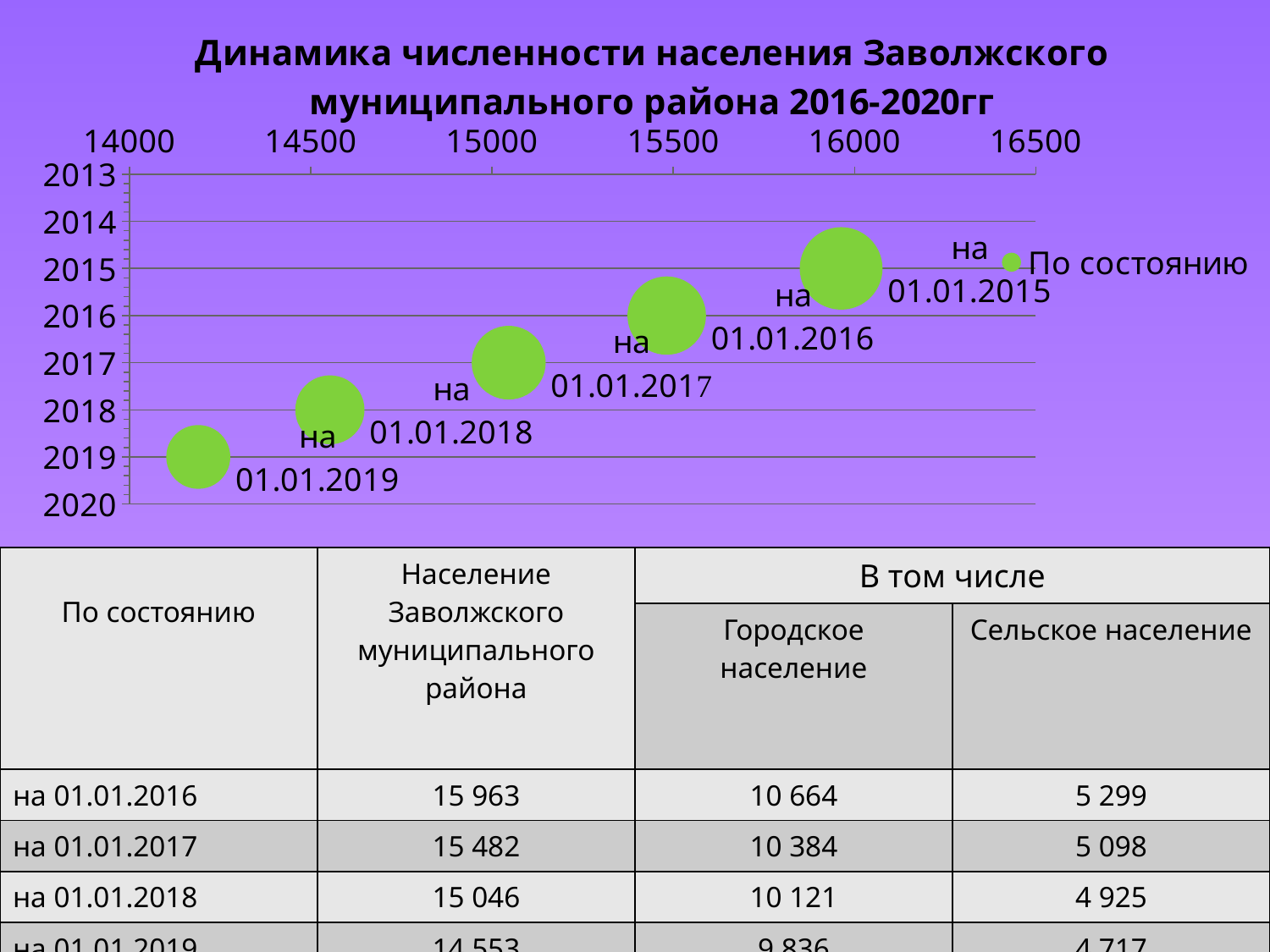
What is the legend entry shown on the chart? По состоянию Which labelled bubble lies furthest to the left on the horizontal axis (the lowest value)? на 01.01.2019 Which bubble has the larger value: 'на 01.01.2016' or 'на 01.01.2018'? на 01.01.2016 Do the plotted values rise or fall as the years on the vertical axis go from 2015 to 2019? fall How many bubbles (data points) are plotted on the chart? 5 Which labelled bubble lies furthest to the right on the horizontal axis (the highest value)? на 01.01.2015 Is the value for the bubble labelled 'на 01.01.2015' greater or less than 15500? greater What is the title of the chart? Динамика численности населения Заволжского муниципального района 2016-2020гг How many series does the chart legend list? 1 Is the value for the bubble labelled 'на 01.01.2019' greater or less than 14500? less Is the value for the bubble labelled 'на 01.01.2018' greater or less than 15000? less What kind of chart is shown on the slide? bubble chart